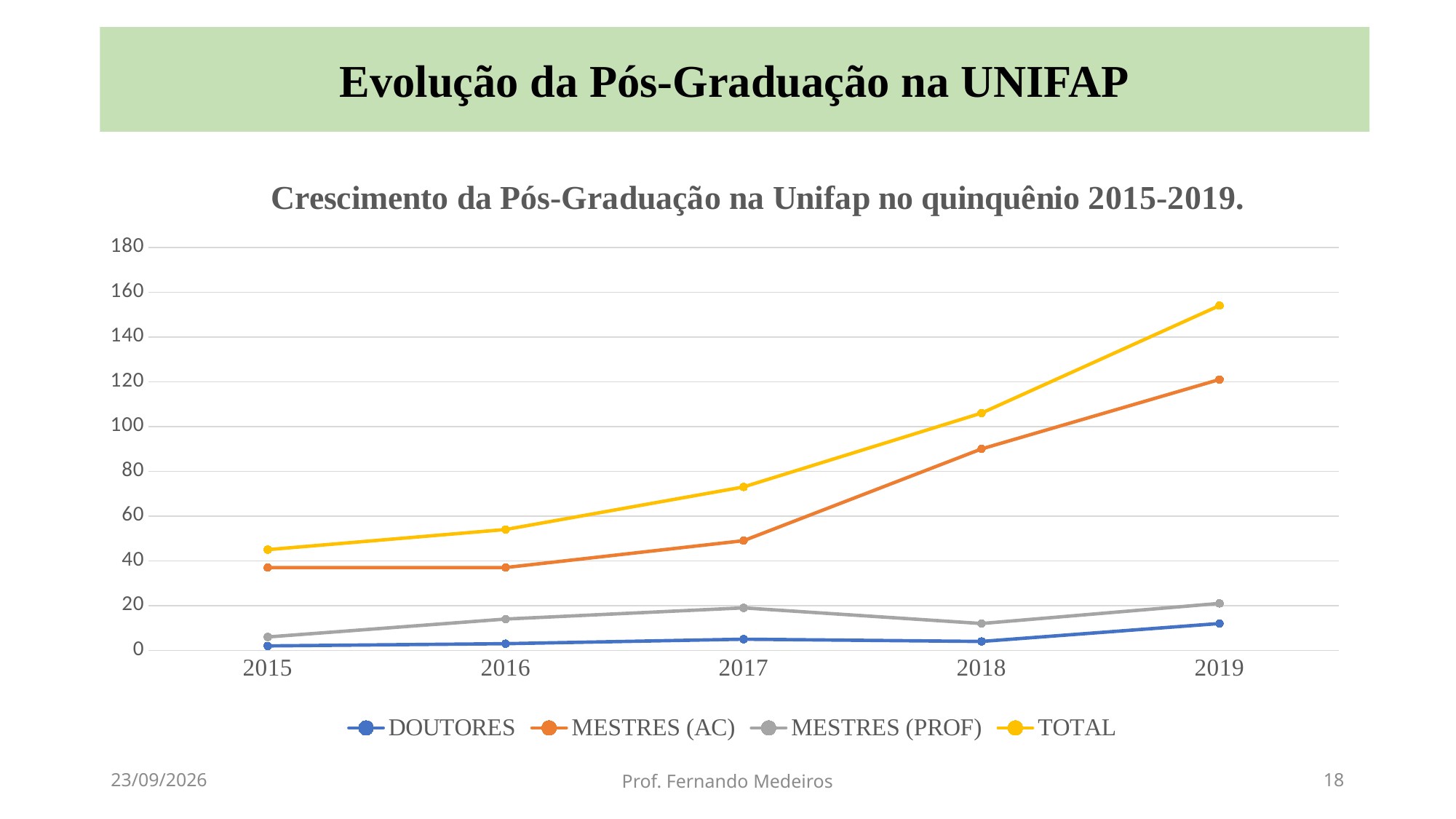
How many years are plotted along the x axis? 5 Is the value for TOTAL in 2018 greater or less than 100? greater In which year is the MESTRES (PROF) series lowest? 2015 Is the value for DOUTORES in 2019 greater or less than 20? less Is the value for TOTAL in 2015 greater or less than 60? less How many series does the legend list? 4 In 2019, which is larger: MESTRES (AC) or MESTRES (PROF)? MESTRES (AC) Does the TOTAL series rise or fall from 2015 to 2019? rise What kind of chart is shown on the slide? line chart In which year is the TOTAL series highest? 2019